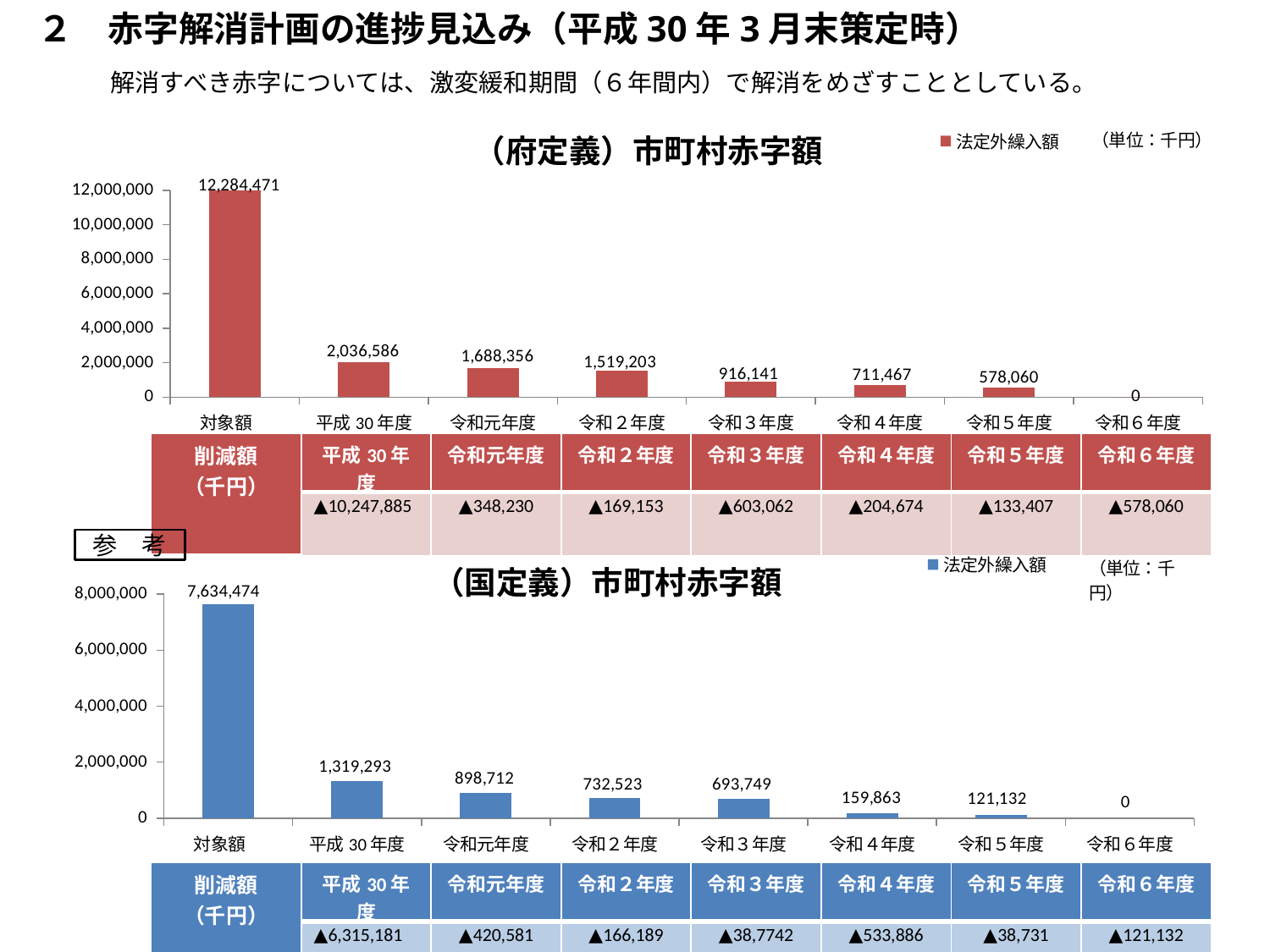
What type of chart is the （国定義）市町村赤字額 chart? Bar chart In the （国定義）市町村赤字額 chart, what is the value for 令和５年度? 121,132 In the （府定義）市町村赤字額 chart, what is the value for 令和３年度? 916,141 In the （国定義）市町村赤字額 chart, what is the difference between the values for 令和３年度 and 令和４年度? 533,886 In the （府定義）市町村赤字額 chart, what is the difference between the values for 平成30年度 and 令和元年度? 348,230 In the （国定義）市町村赤字額 chart, what is the value for 平成30年度? 1,319,293 In the （府定義）市町村赤字額 chart, do the values rise or fall from 平成30年度 to 令和６年度? Fall In the （国定義）市町村赤字額 chart, which is larger, the value for 令和元年度 or the value for 令和２年度? 令和元年度 How many categories are shown on the x axis of the （府定義）市町村赤字額 chart? 8 In the （府定義）市町村赤字額 chart, what is the value for 対象額? 12,284,471 In the （国定義）市町村赤字額 chart, which category has the lowest value? 令和６年度 In the （府定義）市町村赤字額 chart, which category has the highest value? 対象額